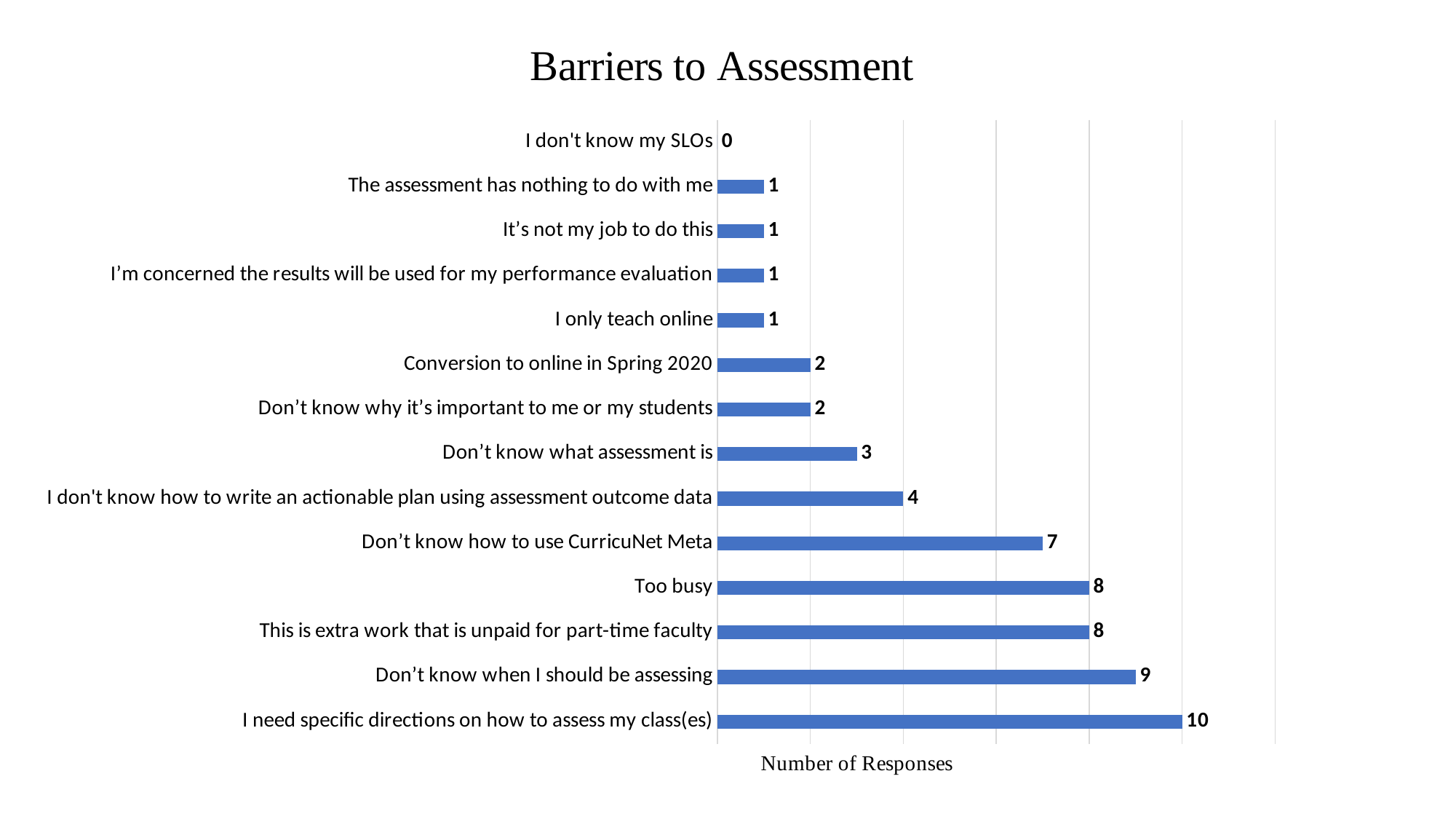
What is the title of the chart? Barriers to Assessment Which has more responses: "Don't know what assessment is" or "I don't know how to write an actionable plan using assessment outcome data"? I don't know how to write an actionable plan using assessment outcome data Which barrier has the highest number of responses? I need specific directions on how to assess my class(es) How many responses does "Conversion to online in Spring 2020" have? 2 What kind of chart is shown on the slide? Bar chart Which has more responses: "Don't know when I should be assessing" or "Too busy"? Don't know when I should be assessing What is the difference in responses between "Don't know how to use CurricuNet Meta" and "Don't know what assessment is"? 4 How many responses are shown for "Too busy"? 8 What is the difference in responses between "I need specific directions on how to assess my class(es)" and "Don't know when I should be assessing"? 1 What is the number of responses for "Don't know how to use CurricuNet Meta"? 7 Which barrier has the lowest number of responses? I don't know my SLOs How many barrier categories are plotted in the chart? 14